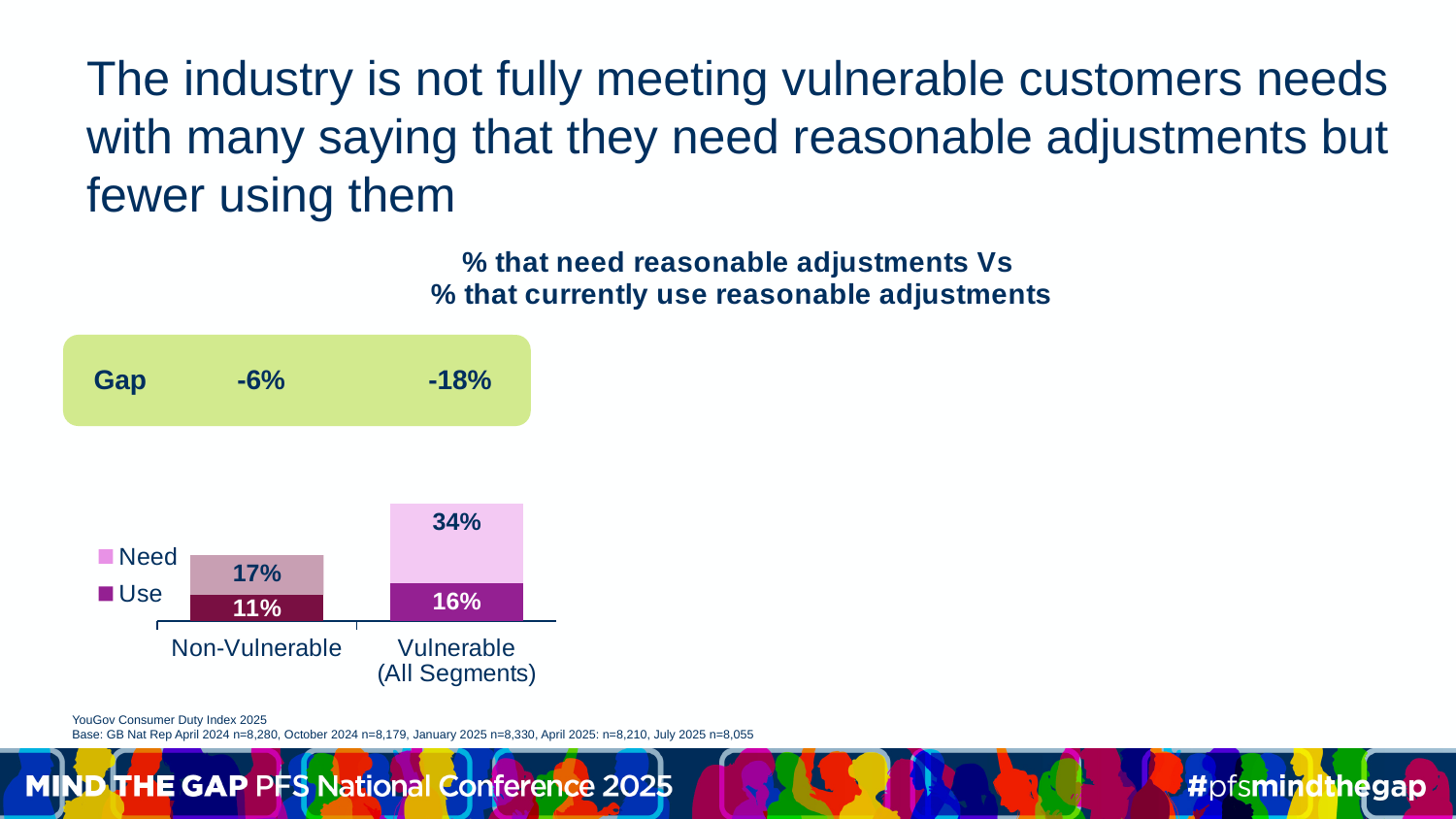
What gap value is shown for Non-Vulnerable in the green box above the chart? -6% What is the difference between the 'Need' and 'Use' values for Vulnerable (All Segments)? 18% What is the 'Need' value for Non-Vulnerable? 17% What is the 'Use' value for Vulnerable (All Segments)? 16% Is the 'Use' value larger for Non-Vulnerable or for Vulnerable (All Segments)? Vulnerable (All Segments) What is the 'Need' value for Vulnerable (All Segments)? 34% How many categories are shown on the x axis? 2 What is the 'Use' value for Non-Vulnerable? 11% How many series does the legend list? 2 What kind of chart is shown? Stacked bar chart Which category has the lower 'Use' value? Non-Vulnerable Which category has the higher 'Need' value? Vulnerable (All Segments)